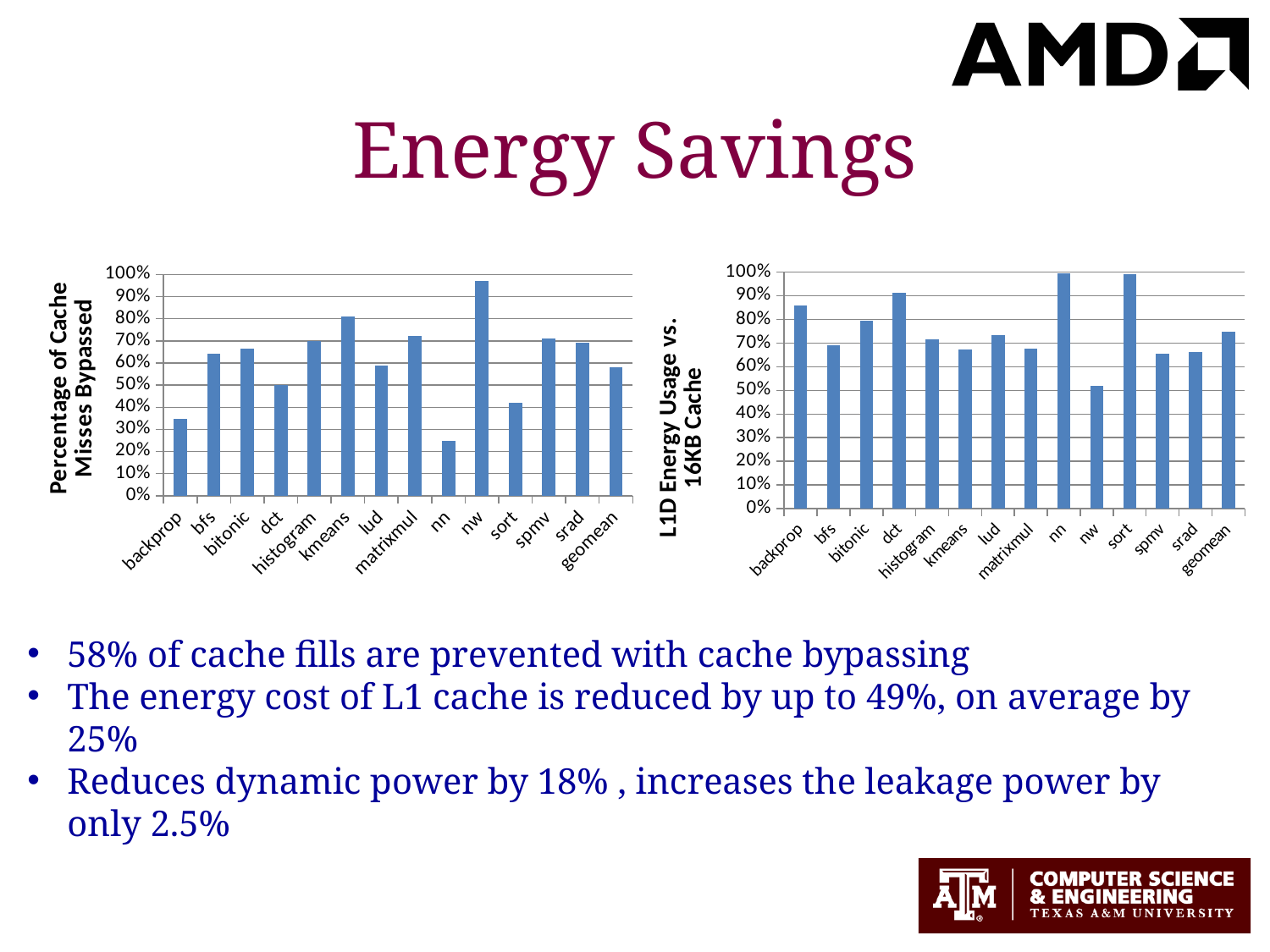
In the left chart (Percentage of Cache Misses Bypassed), which is larger, the value for kmeans or the value for histogram? kmeans In the right chart (L1D Energy Usage vs. 16KB Cache), is the value for dct greater or less than 80%? greater In the right chart (L1D Energy Usage vs. 16KB Cache), is the value for nw greater or less than 40%? greater In the left chart (Percentage of Cache Misses Bypassed), is the value for kmeans greater or less than 70%? greater In the right chart (L1D Energy Usage vs. 16KB Cache), which benchmark has the lowest bar? nw In the left chart (Percentage of Cache Misses Bypassed), which benchmark has the lowest bar? nn In the left chart (Percentage of Cache Misses Bypassed), which benchmark has the highest bar? nw What is the y-axis label of the right chart? L1D Energy Usage vs. 16KB Cache What kind of chart is the left chart (Percentage of Cache Misses Bypassed)? bar chart How many benchmark categories are shown on the x axis of the right chart (L1D Energy Usage vs. 16KB Cache)? 14 In the right chart (L1D Energy Usage vs. 16KB Cache), which is larger, the value for backprop or the value for bfs? backprop